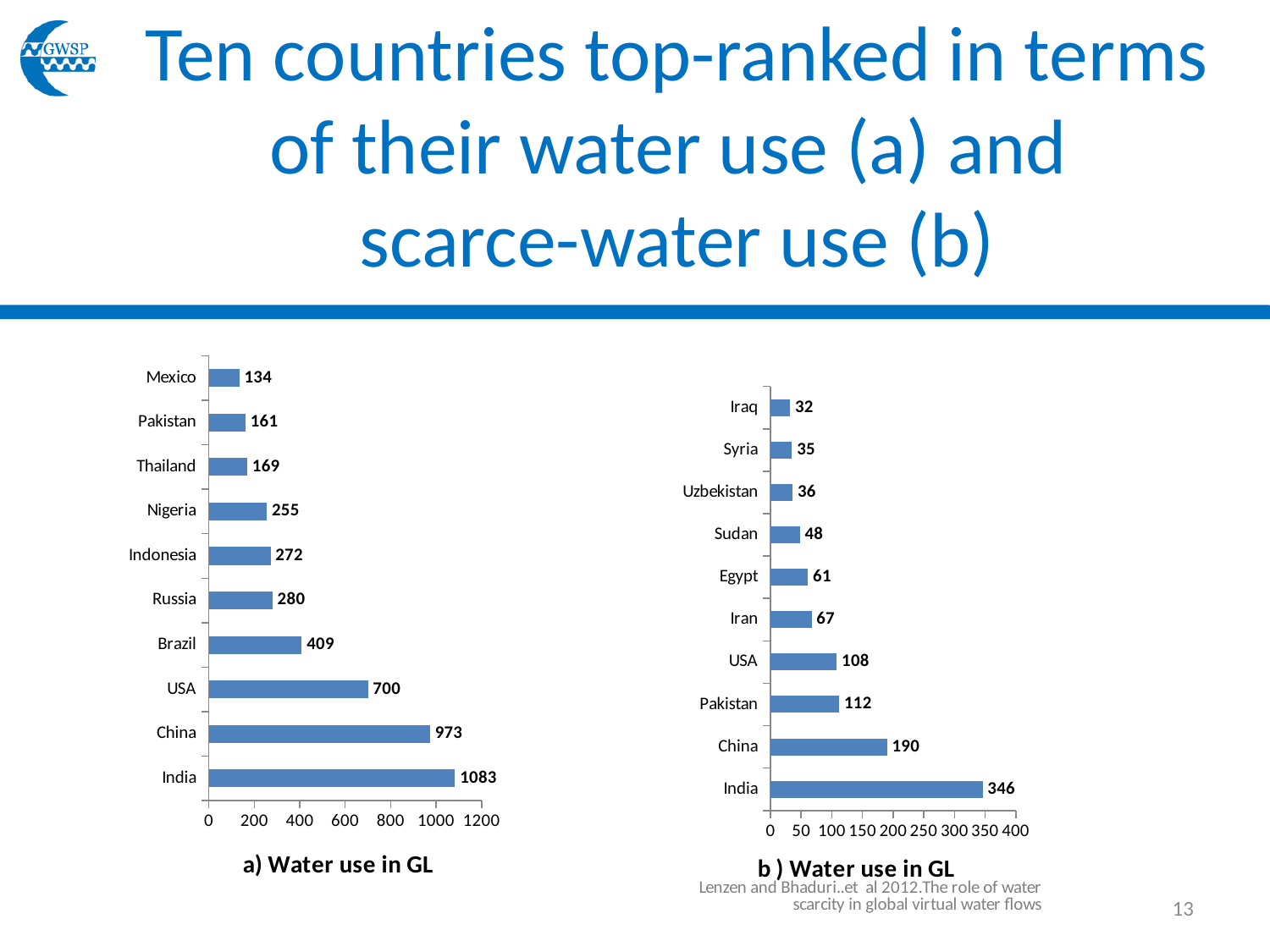
In the left chart (a) Water use in GL, which is larger, the value for Brazil or the value for Russia? Brazil In the left chart (a) Water use in GL, what is the value for Pakistan? 161 In the left chart (a) Water use in GL, what is the difference between the values for India and China? 110 In the left chart (a) Water use in GL, which country has the highest value? India In the right chart (b) Water use in GL, is the value for USA greater or less than 100? greater In the right chart (b) Water use in GL, what is the value for Egypt? 61 In the right chart (b) Water use in GL, which country has the lowest value? Iraq In the right chart (b) Water use in GL, what is the difference between the values for India and China? 156 In the left chart (a) Water use in GL, what is the value for China? 973 How many countries are shown in the left chart (a) Water use in GL? 10 What kind of chart is the right chart (b) Water use in GL? bar chart What is the maximum value shown on the x axis of the right chart (b) Water use in GL? 400